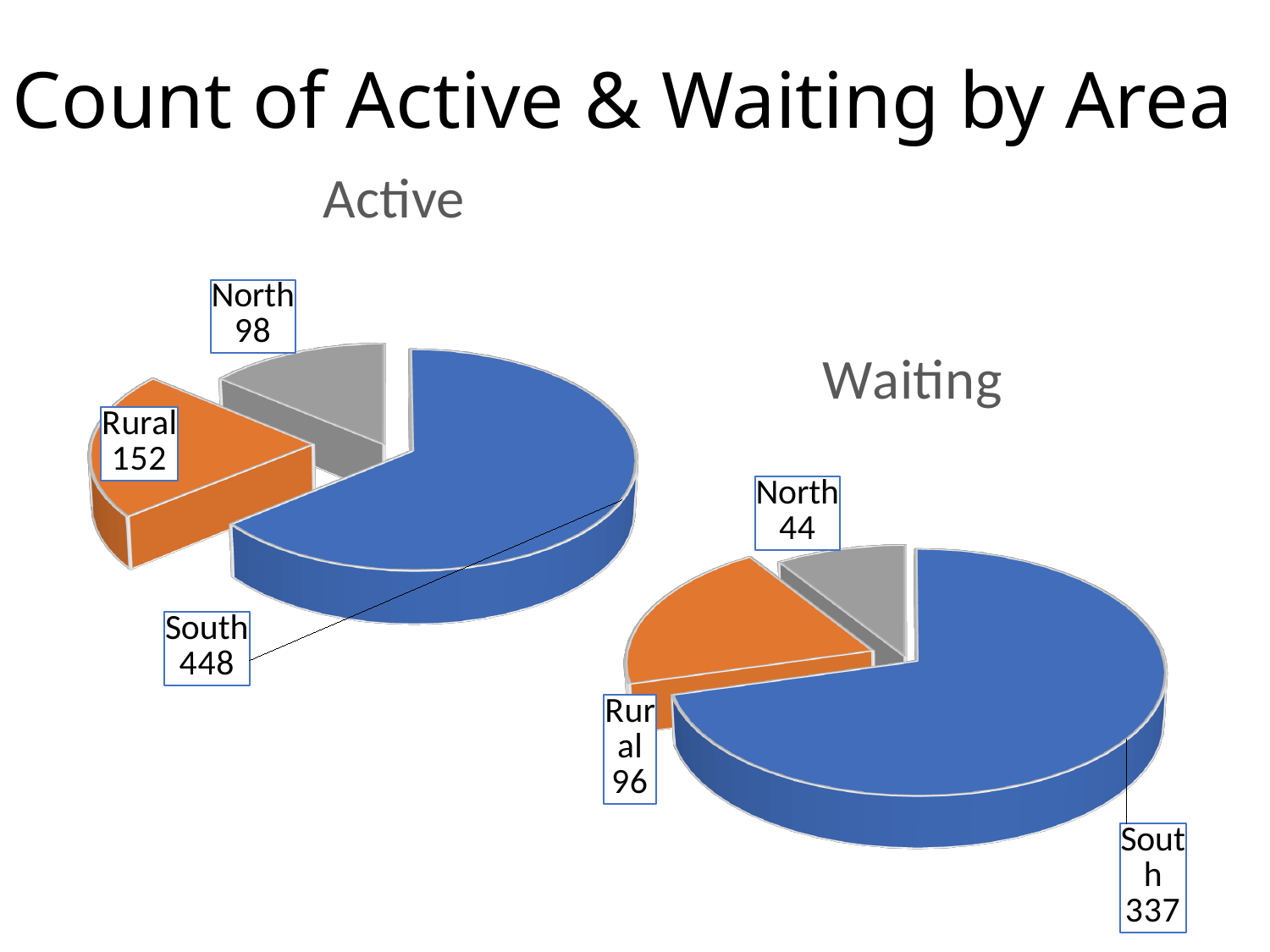
In the Waiting chart, what is the value for North? 44 In the Waiting chart, which area has the smallest slice? North In the Active chart, which area has the largest slice? South What is the title of the slide? Count of Active & Waiting by Area In the Active chart, what is the difference between the Rural and North values? 54 Which is larger: the South value in the Active chart or the South value in the Waiting chart? Active In the Active chart, what is the value for Rural? 152 How many slices does the Waiting chart have? 3 In the Waiting chart, what is the difference between the South and Rural values? 241 In the Waiting chart, what is the value for Rural? 96 What type of chart is the Active chart? Pie chart In the Active chart, what is the value for South? 448